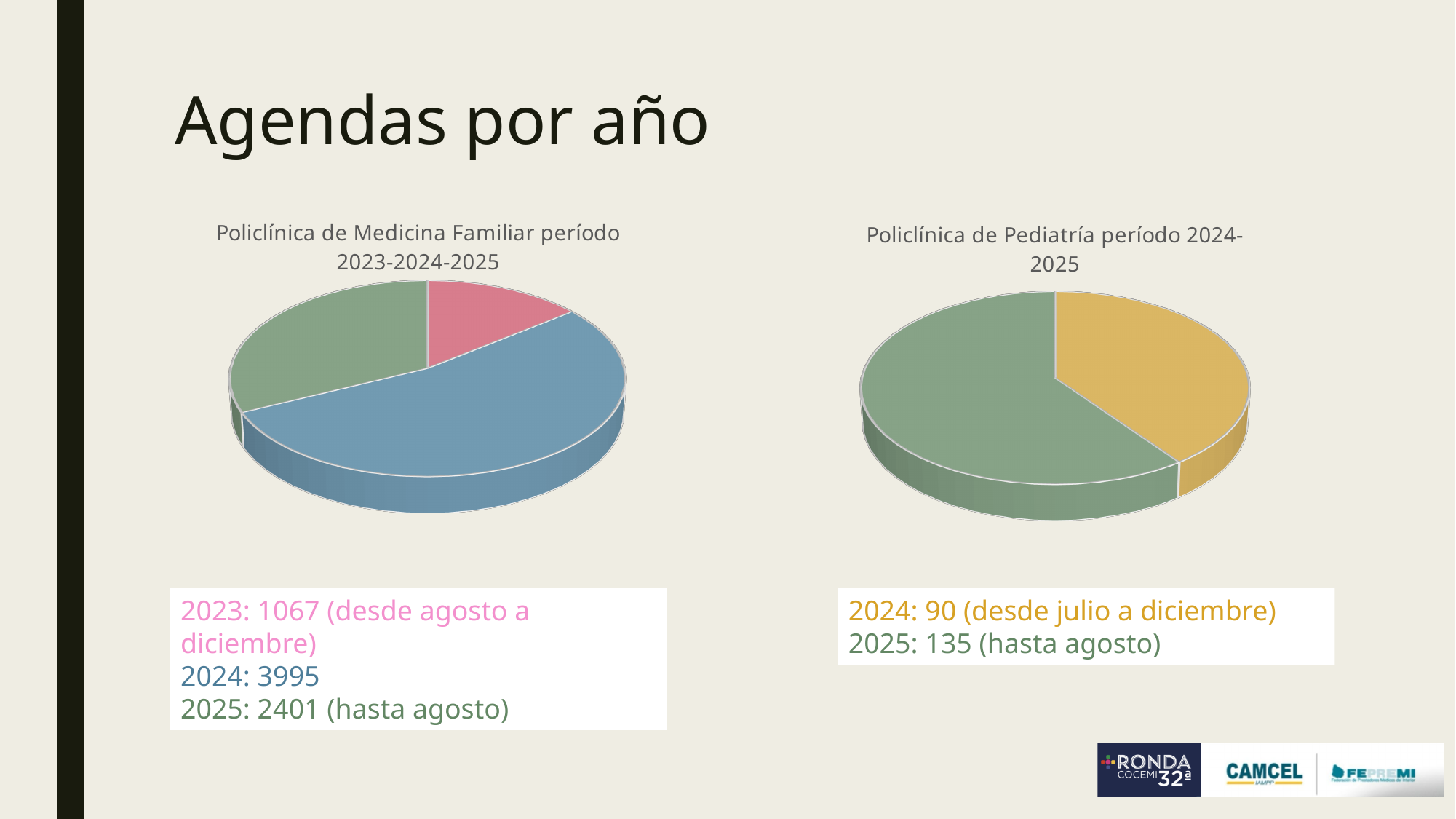
In the Policlínica de Medicina Familiar chart, what is the value for 2024? 3995 In the Policlínica de Pediatría chart, which year is larger, 2024 or 2025? 2025 In the Policlínica de Medicina Familiar chart, what is the value for 2023? 1067 In the Policlínica de Medicina Familiar chart, which year has the largest slice? 2024 In the Policlínica de Medicina Familiar chart, what is the difference between the 2024 and 2025 values? 1594 What type of chart is used for the Policlínica de Medicina Familiar data? Pie chart In the Policlínica de Pediatría chart, what is the value for 2025? 135 In the Policlínica de Pediatría chart, what is the total of the two slices? 225 In the Policlínica de Medicina Familiar chart, which year has the smallest slice? 2023 In the Policlínica de Pediatría chart, what share of the pie does 2025 represent? 60% In the Policlínica de Pediatría chart, how many slices (years) are shown? 2 In the Policlínica de Medicina Familiar chart, how many slices (years) are shown? 3